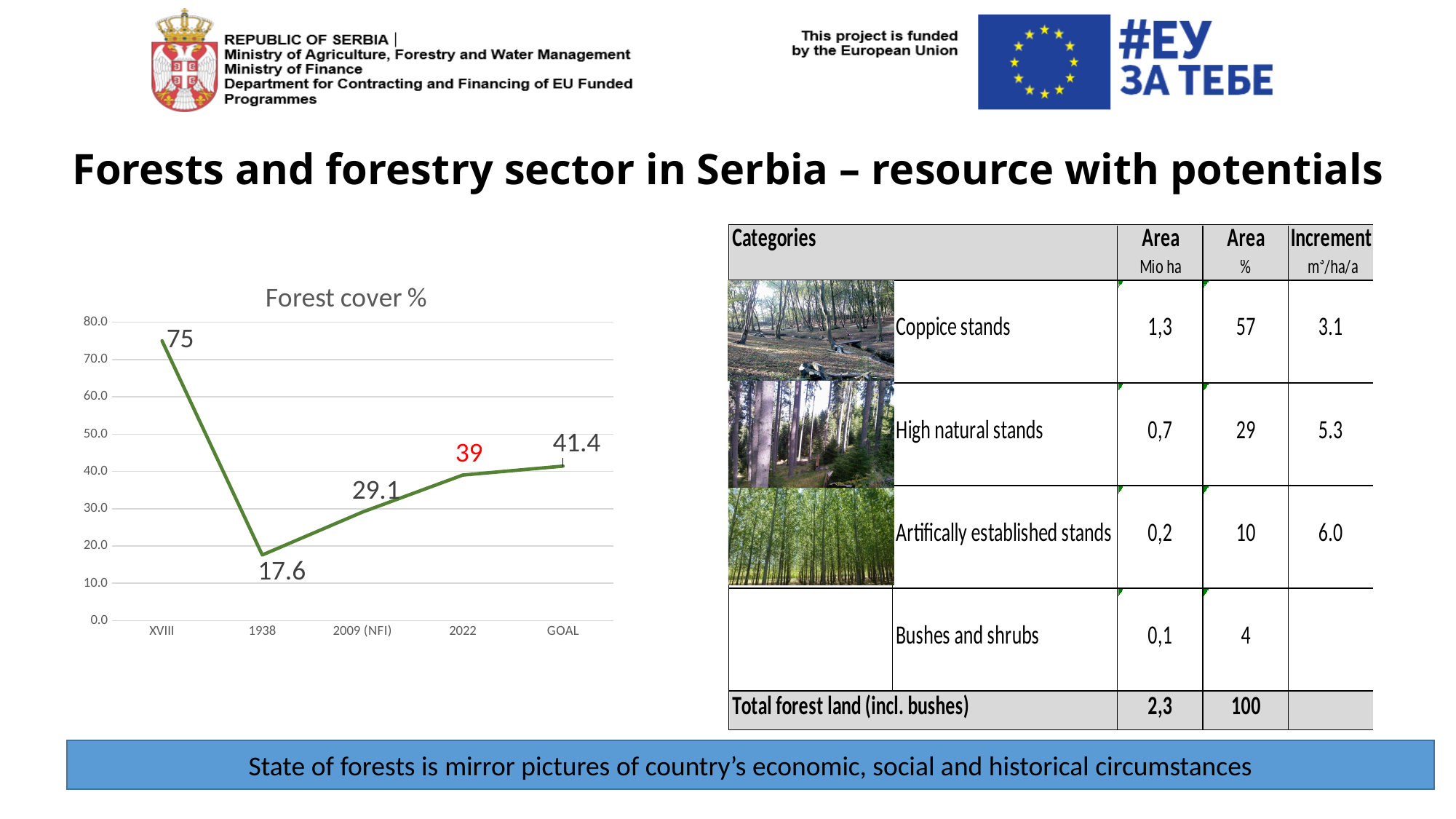
Which category has the lowest forest cover value? 1938 Does the forest cover value rise or fall from 1938 to GOAL? rise What is the title of the chart on the slide? Forest cover % What is the difference between the forest cover values for XVIII and 1938? 57.4 What is the forest cover value for GOAL? 41.4 How many data points are plotted on the Forest cover % chart? 5 Which is larger, the forest cover value for 2022 or for 2009 (NFI)? 2022 Which category has the highest forest cover value? XVIII What is the forest cover value for 2009 (NFI)? 29.1 What type of chart is shown on the slide? line chart What is the forest cover value for 1938? 17.6 What is the forest cover value for 2022? 39